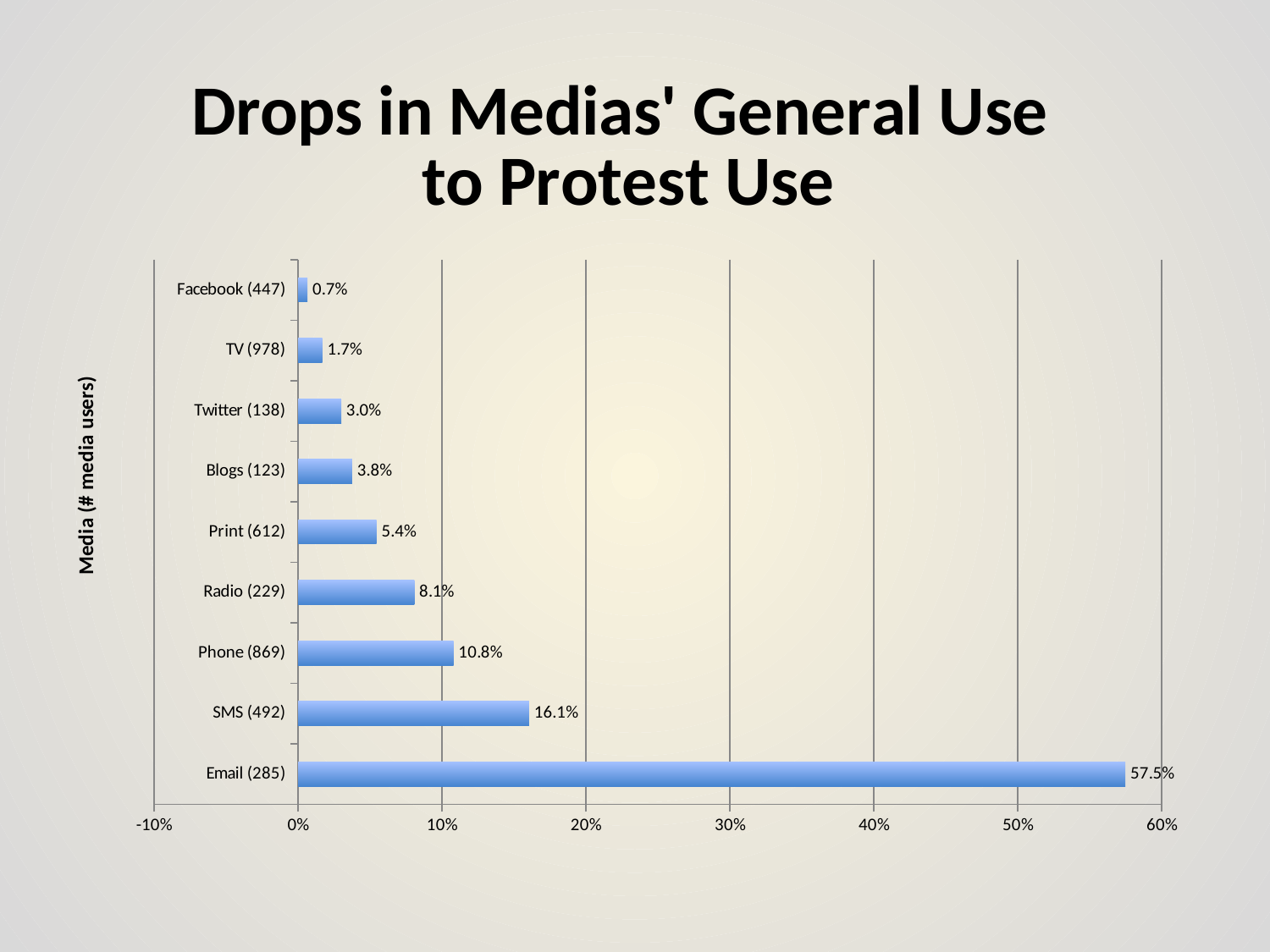
How many media categories are shown in the chart? 9 What is the label of the vertical axis? Media (# media users) What is the value for Blogs (123)? 3.8% Which has a larger value, Print (612) or Twitter (138)? Print (612) What kind of chart is shown on the slide? Bar chart What is the difference between the values for SMS (492) and Radio (229)? 8.0% Which media category has the lowest value? Facebook (447) What is the title of the chart on the slide? Drops in Medias' General Use to Protest Use What is the value for Email (285)? 57.5% What is the value for Phone (869)? 10.8% Is the value for SMS (492) greater or less than 20%? less Which media category has the highest value? Email (285)